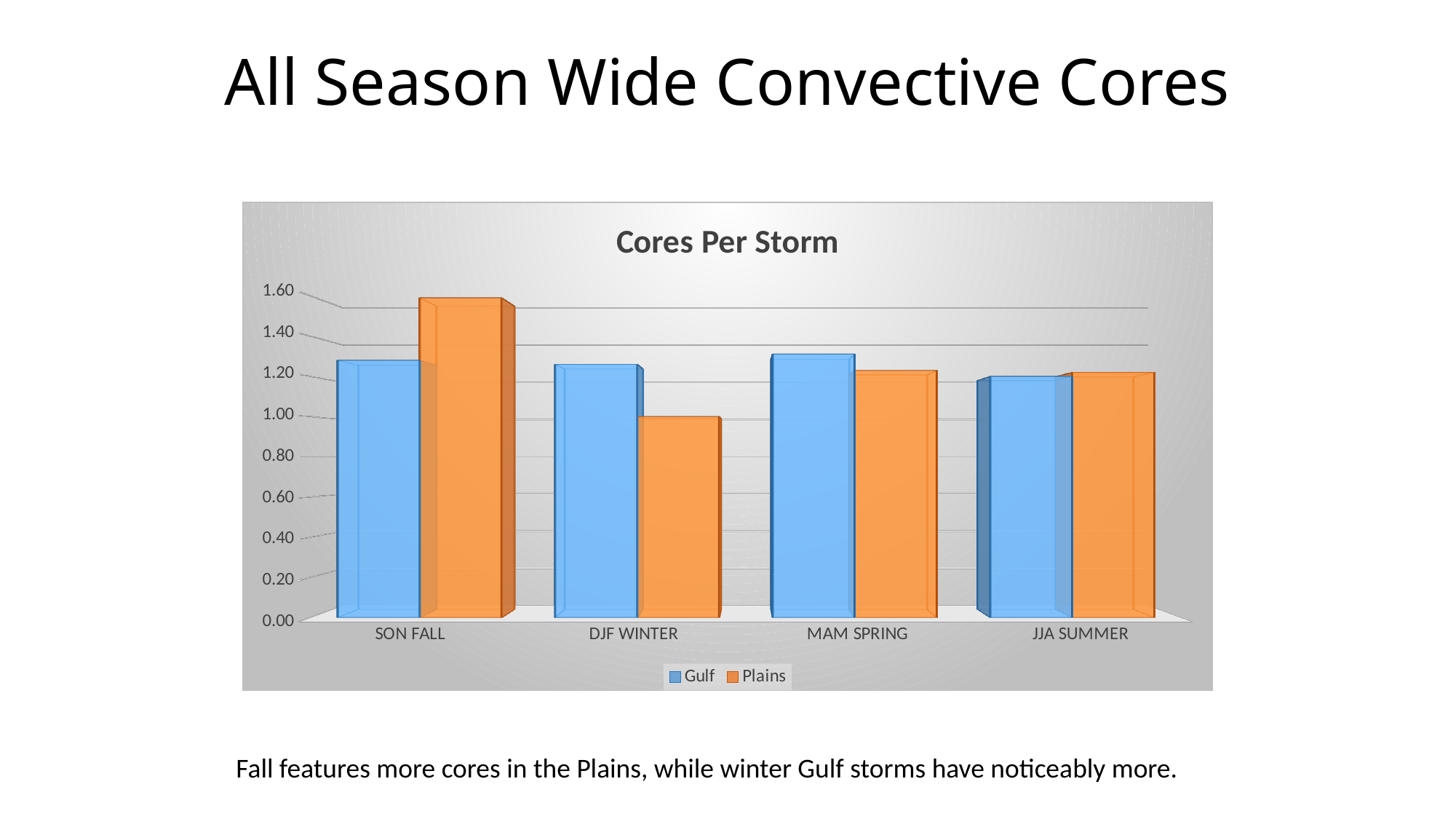
Is the Gulf value for MAM SPRING greater or less than 1.00? greater Which colour represents the Plains series in the chart? orange Is the Plains value for SON FALL greater or less than 1.40? greater In which season is the Plains value lowest? DJF WINTER Is the Plains value for DJF WINTER greater or less than 1.20? less In which season is the Plains value highest? SON FALL For DJF WINTER, which series has the larger value, Gulf or Plains? Gulf For SON FALL, which series has the larger value, Gulf or Plains? Plains What is the title of the chart? Cores Per Storm How many seasons are shown on the x axis of the chart? 4 How many series does the chart legend list? 2 What kind of chart is shown on the slide? bar chart